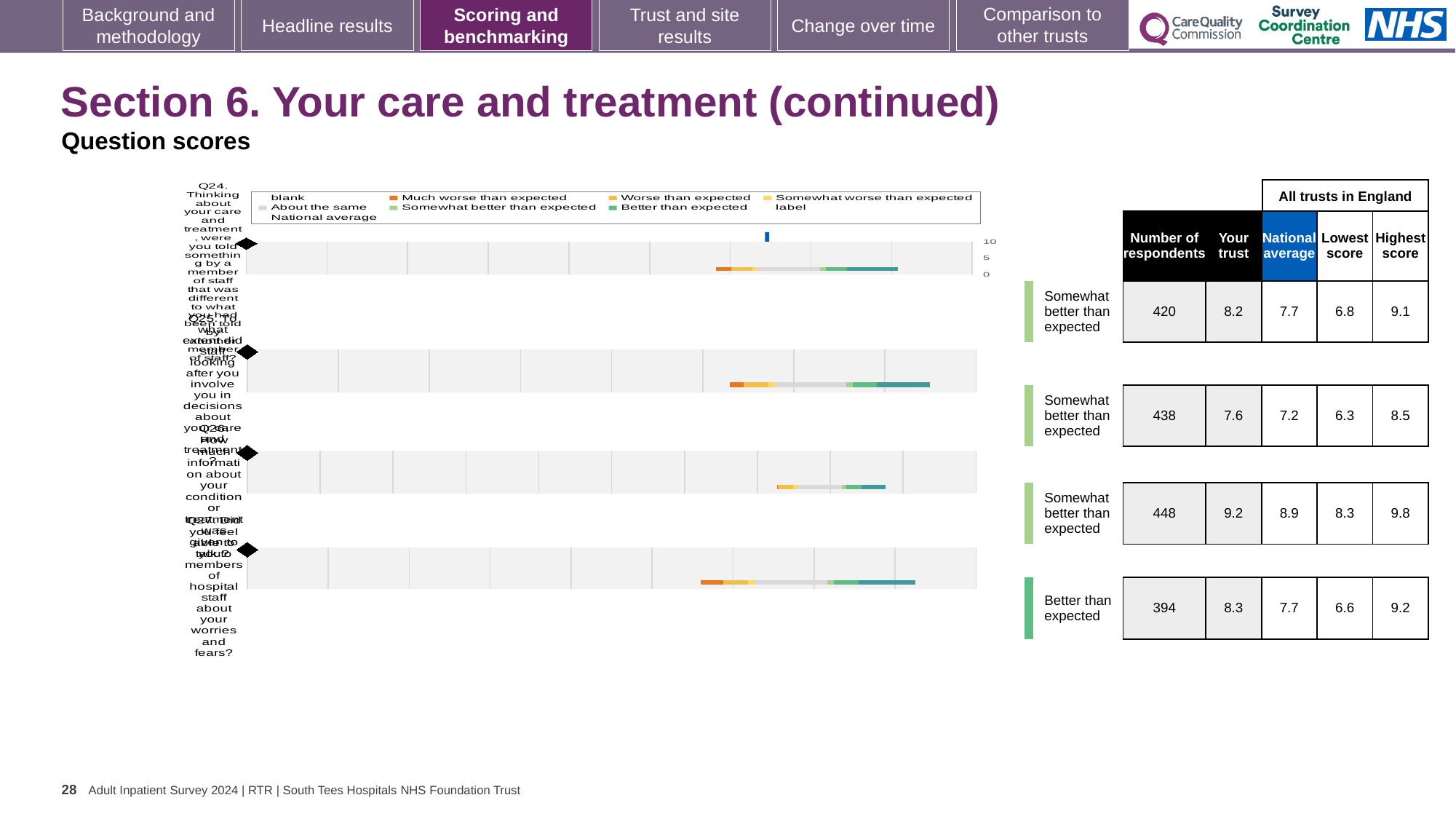
What is the national average for the first question (Q24)? 7.7 How many of the four questions are rated 'Somewhat better than expected'? 3 What is the highest score listed for the third row of the table? 9.8 What is the 'Your trust' score for the first question (Q24) in the table? 8.2 Which row of the table has the lowest number of respondents? the fourth row (394) For the first question (Q24), what is the difference between the 'Your trust' score and the national average? 0.5 How many respondents are listed for the first question (Q24)? 420 For the first question (Q24), which is larger: the 'Your trust' score or the national average? Your trust How many questions (rows) are plotted in the chart on this slide? 4 What benchmark rating is shown for the fourth (bottom) question? Better than expected Which row of the table has the highest 'Your trust' score? the third row (9.2) What kind of chart is used to show the question scores on this slide? bar chart